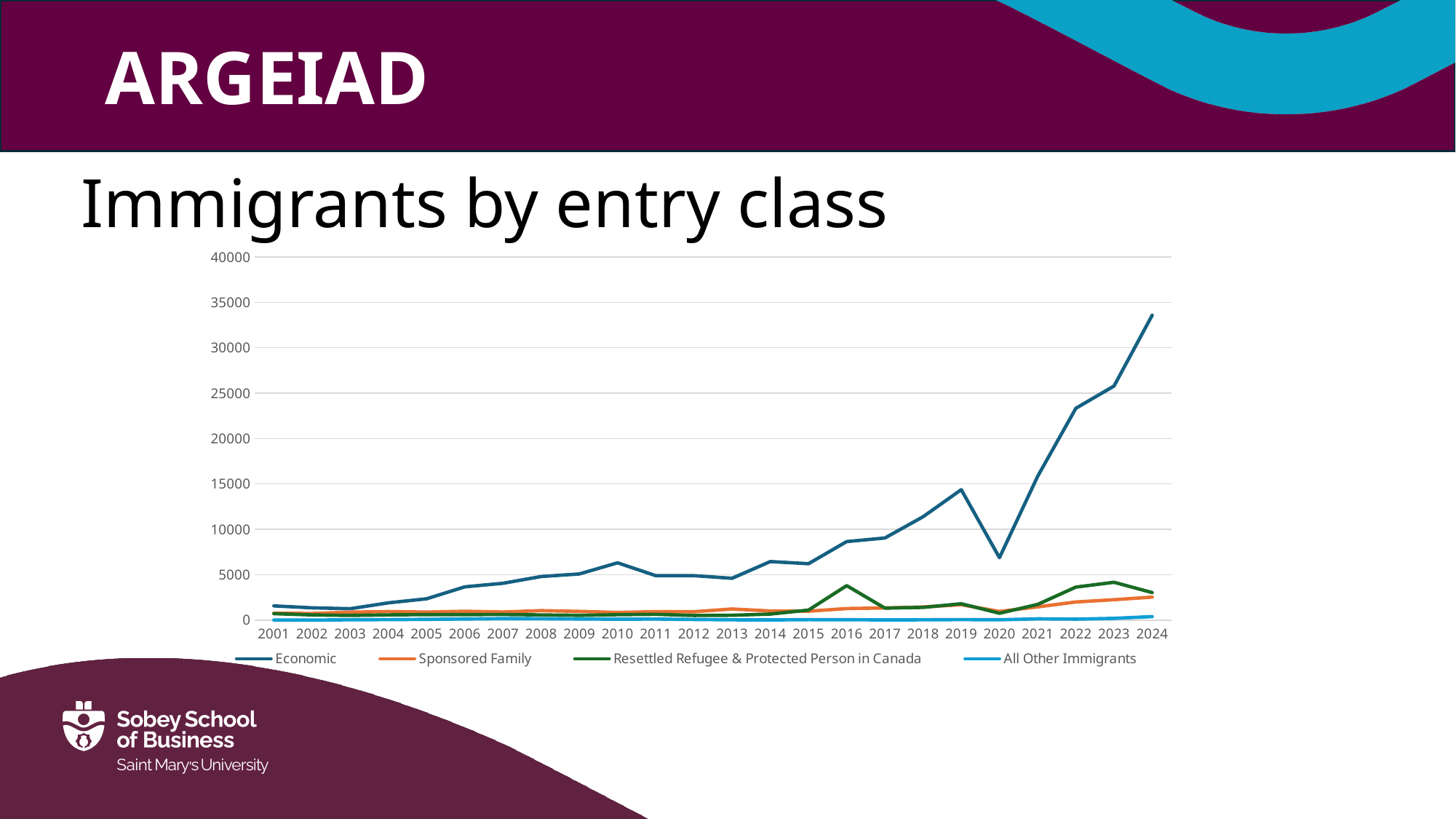
What kind of chart is shown on the slide? Line chart Is the value for Economic in 2022 greater or less than 20000? greater Which entry class has the lowest value in 2024? All Other Immigrants In 2024, which is larger: Economic or Sponsored Family? Economic Is the value for Resettled Refugee & Protected Person in Canada in 2016 greater or less than 5000? less How many series does the legend list? 4 Which entry class has the highest value in 2024? Economic Is the value for Economic in 2024 greater or less than 30000? greater Does the Economic series generally rise or fall from 2001 to 2024? Rise What is the title of the chart? Immigrants by entry class How many years are shown along the x axis? 24